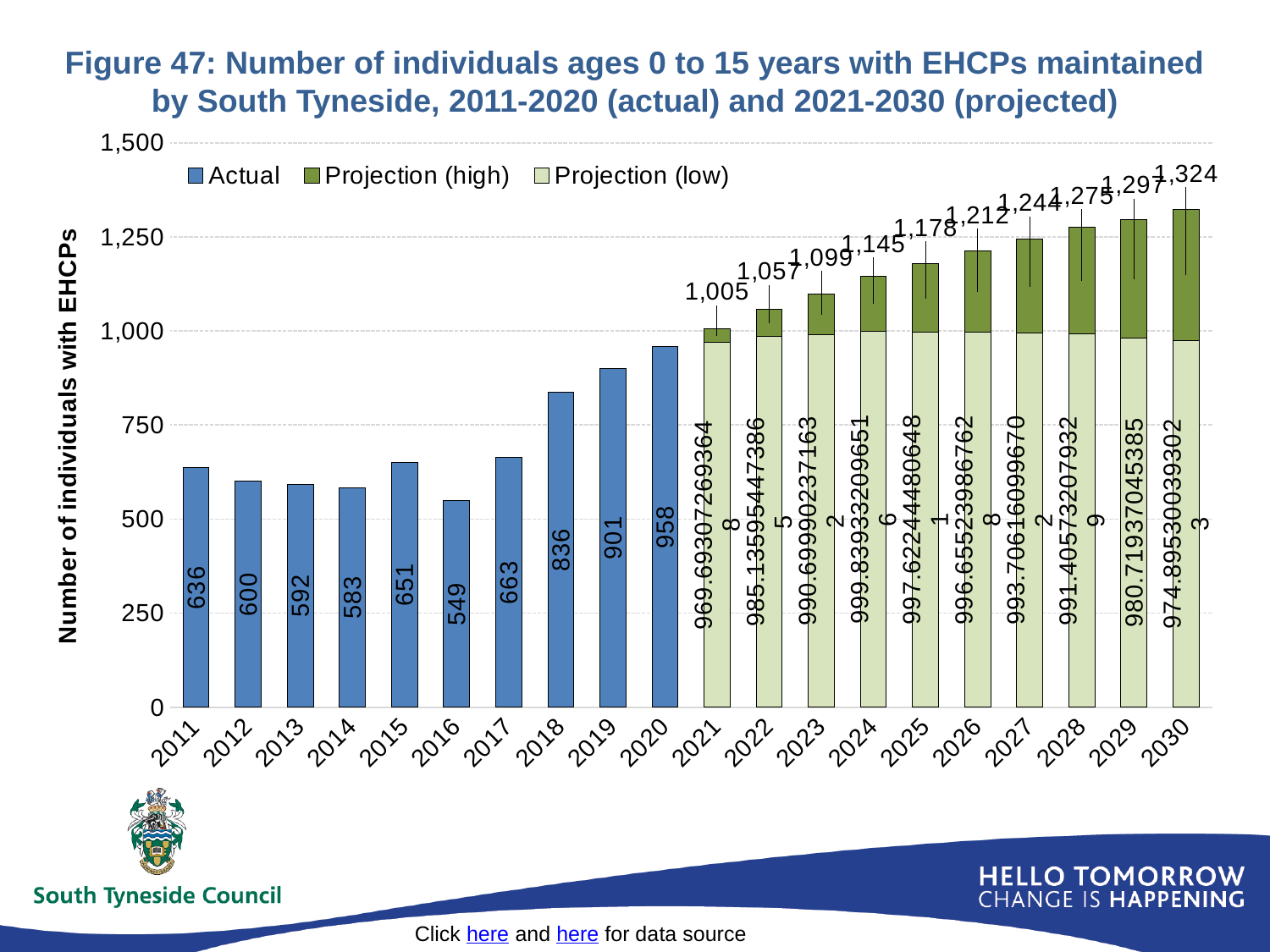
What is the Projection (high) value for 2021? 1,005 Which is larger, the Actual value for 2015 or for 2017? 2017 Do the Projection (high) values rise or fall from 2021 to 2030? Rise How many series does the legend list? 3 How many years are shown on the x axis? 20 What is the Actual value for 2020? 958 What is the Projection (high) value for 2030? 1,324 What is the difference between the Actual values for 2020 and 2019? 57 What kind of chart is shown? Bar chart What is the Actual value for 2011? 636 Which year has the highest Actual value? 2020 Which year has the lowest Actual value? 2016